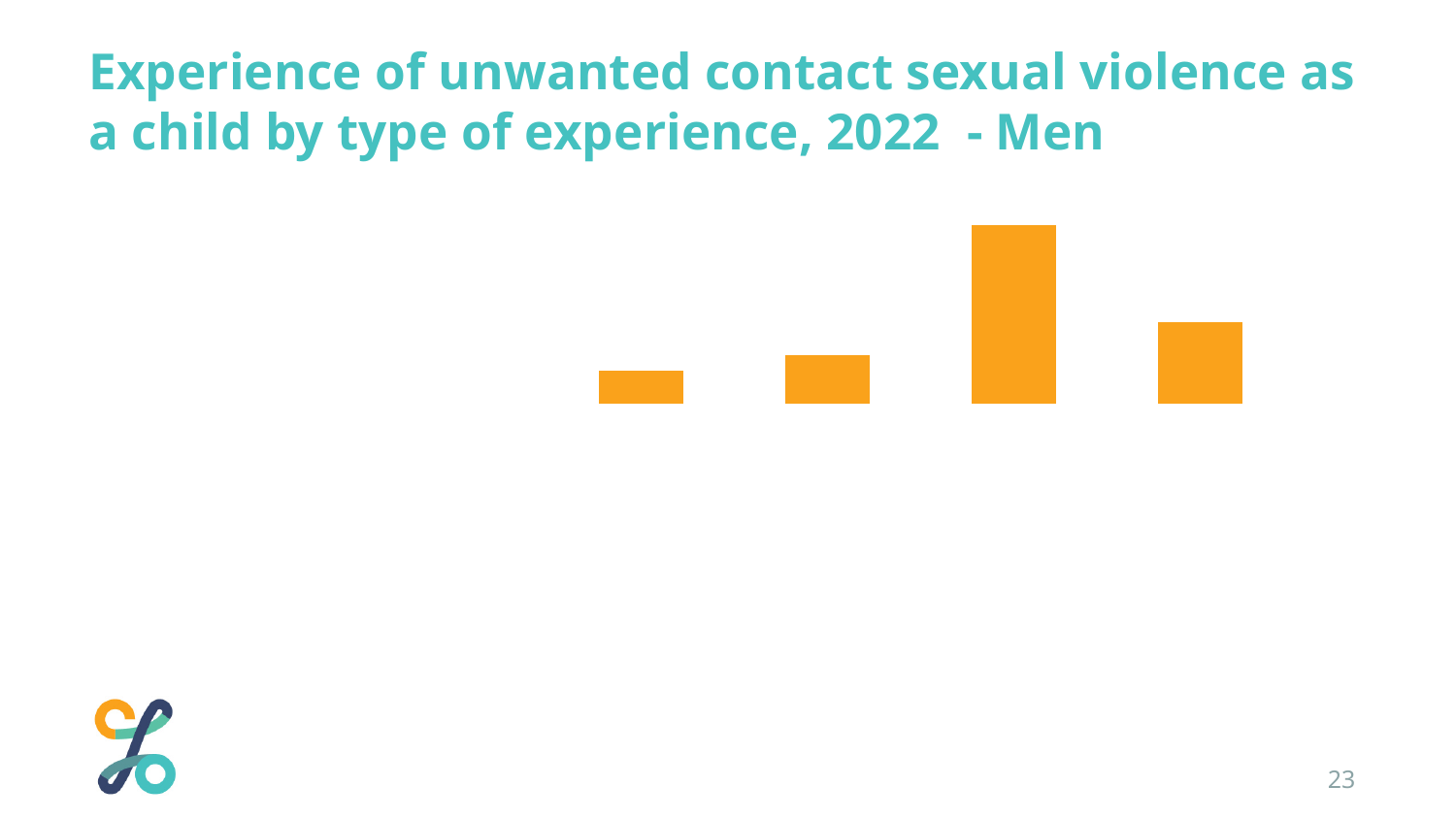
Which is taller, the second bar from the left or the fourth bar from the left? the fourth bar What kind of chart is shown on the slide? bar chart Which is taller, the first bar from the left or the second bar from the left? the second bar What colour are the bars in the chart? orange What is the title of the slide containing the chart? Experience of unwanted contact sexual violence as a child by type of experience, 2022 - Men Which is taller, the third bar from the left or the fourth bar from the left? the third bar Which bar is the shortest in the chart, counting from the left? the first bar How many bars are plotted in the chart? 4 Which bar is the tallest in the chart, counting from the left? the third bar